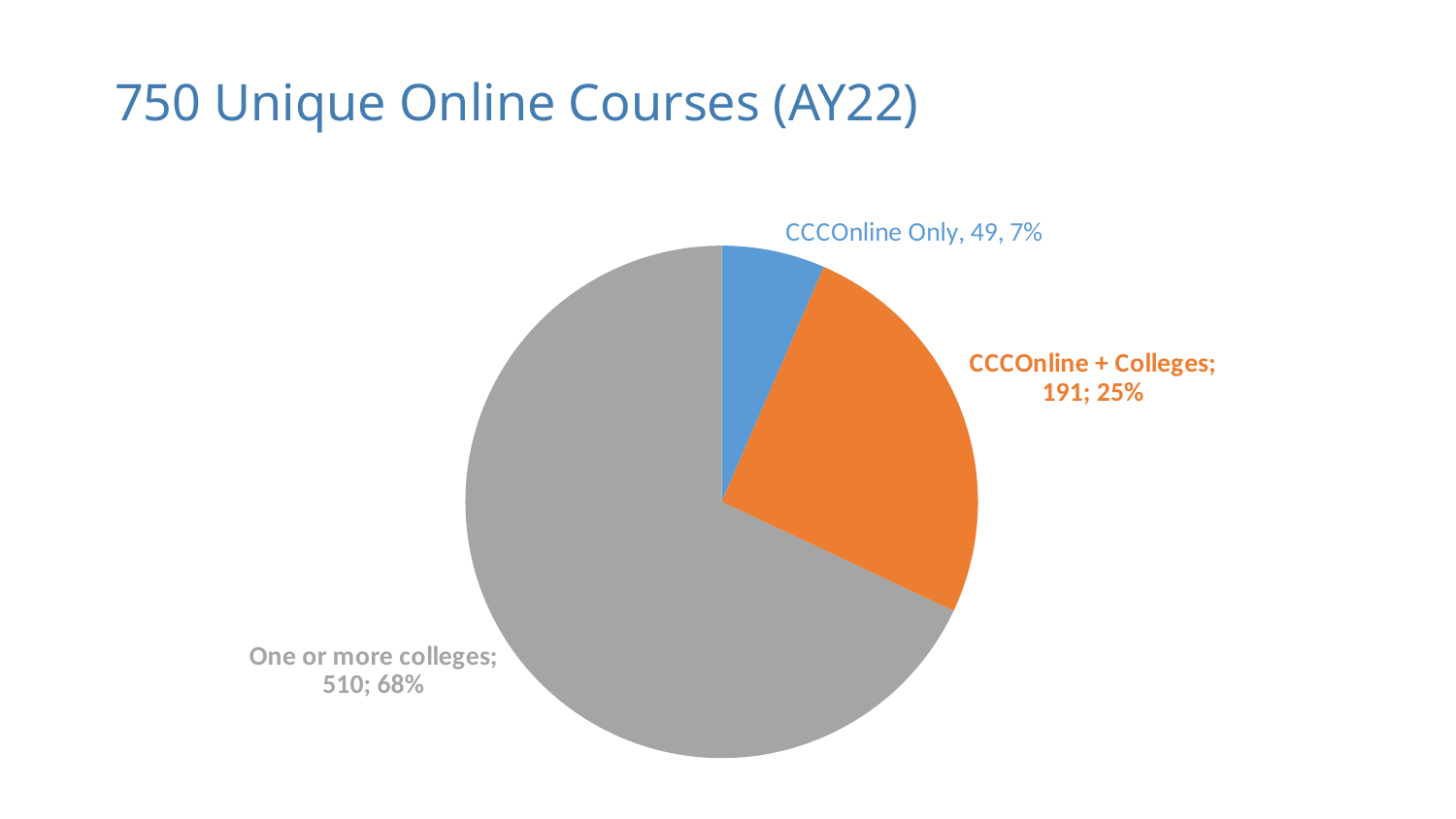
What kind of chart is shown on the slide? pie chart Which is larger, CCCOnline + Colleges or CCCOnline Only? CCCOnline + Colleges Which category has the smallest slice? CCCOnline Only What is the difference between the values for One or more colleges and CCCOnline + Colleges? 319 What share of the pie does the CCCOnline Only slice represent? 7% Which category has the largest slice? One or more colleges What is the value for CCCOnline Only? 49 What is the value for One or more colleges? 510 What is the value for CCCOnline + Colleges? 191 What is the title of the slide? 750 Unique Online Courses (AY22) How many slices does the pie chart have? 3 What share of the pie does the One or more colleges slice represent? 68%